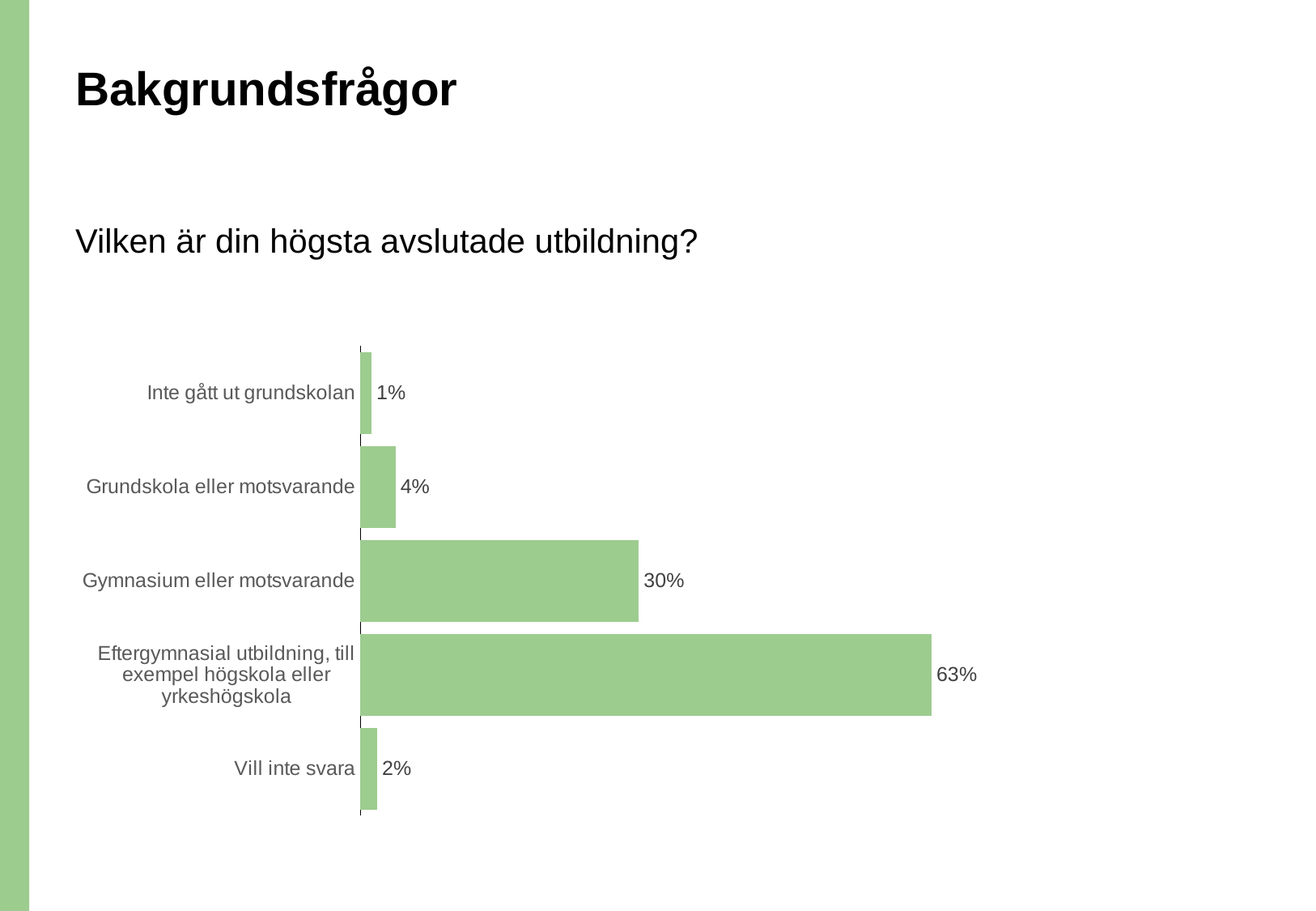
What percentage of respondents answered "Gymnasium eller motsvarande"? 30% What kind of chart is shown on the slide? Bar chart What question does the chart on the slide present results for? Vilken är din högsta avslutade utbildning? What is the value for "Vill inte svara"? 2% Which is larger: the value for "Grundskola eller motsvarande" or for "Vill inte svara"? Grundskola eller motsvarande Which category has the highest value? Eftergymnasial utbildning, till exempel högskola eller yrkeshögskola What is the value shown for "Eftergymnasial utbildning, till exempel högskola eller yrkeshögskola"? 63% What percentage is shown for "Inte gått ut grundskolan"? 1% How many categories are shown in the chart? 5 What is the difference between the values for "Eftergymnasial utbildning" and "Gymnasium eller motsvarande"? 33% What is the difference between the values for "Grundskola eller motsvarande" and "Inte gått ut grundskolan"? 3% Which category has the lowest value? Inte gått ut grundskolan